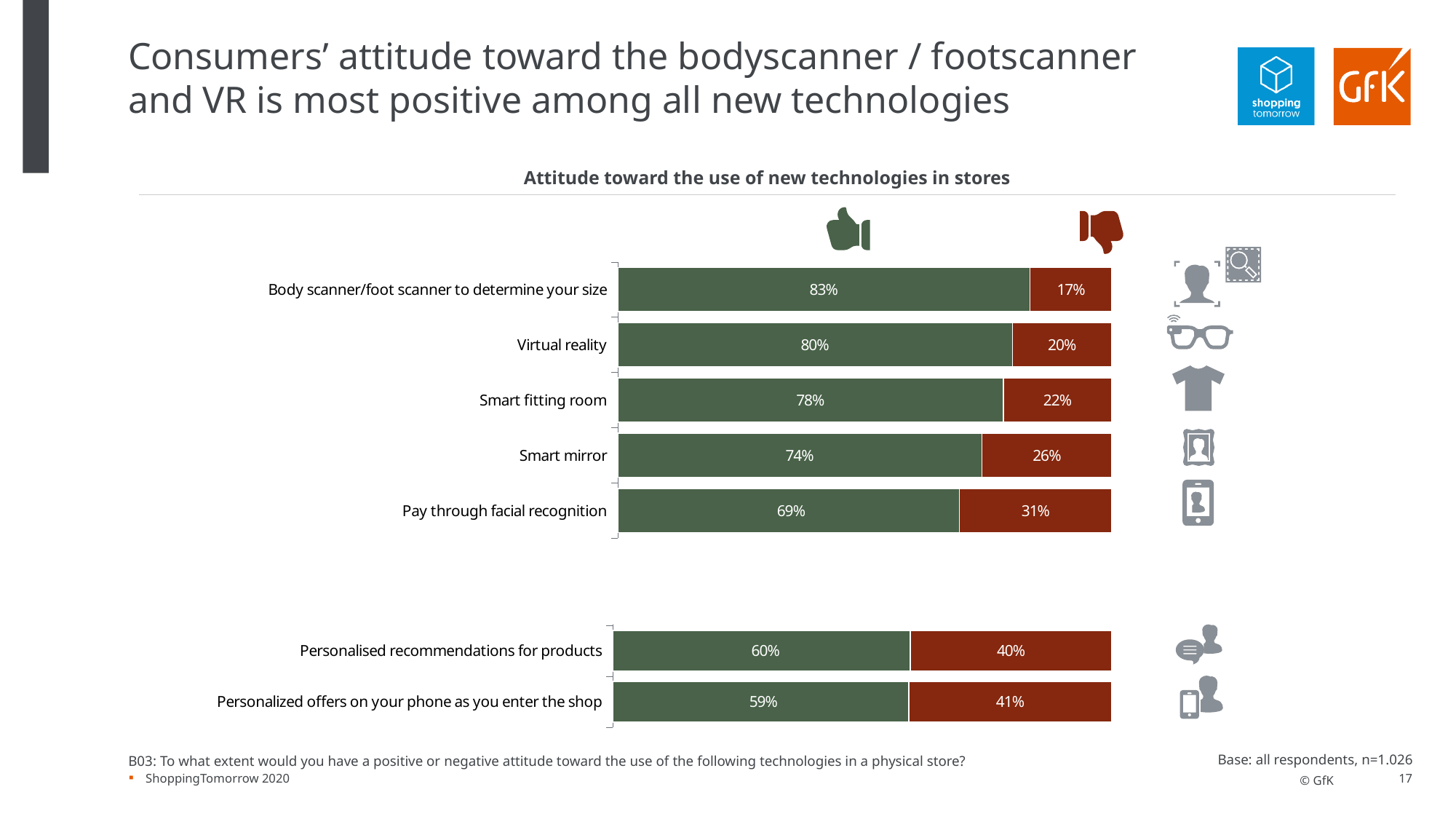
Which technology has the highest positive (thumbs up) share? Body scanner/foot scanner to determine your size What is the difference between the positive shares for Virtual reality and Smart fitting room? 2 percentage points What is the total of the positive and negative shares for Virtual reality? 100% Which technology has the lowest positive share? Personalized offers on your phone as you enter the shop What colour represents the negative (thumbs down) attitude in the chart? Red What percentage of respondents have a positive attitude toward the body scanner/foot scanner to determine your size? 83% Which has a larger negative share: Smart mirror or Personalised recommendations for products? Personalised recommendations for products What is the positive share for Smart mirror? 74% How many technologies are listed in the chart? 7 What type of chart is shown on the slide? Stacked bar chart What is the title of the chart? Attitude toward the use of new technologies in stores What is the negative (thumbs down) share for Pay through facial recognition? 31%